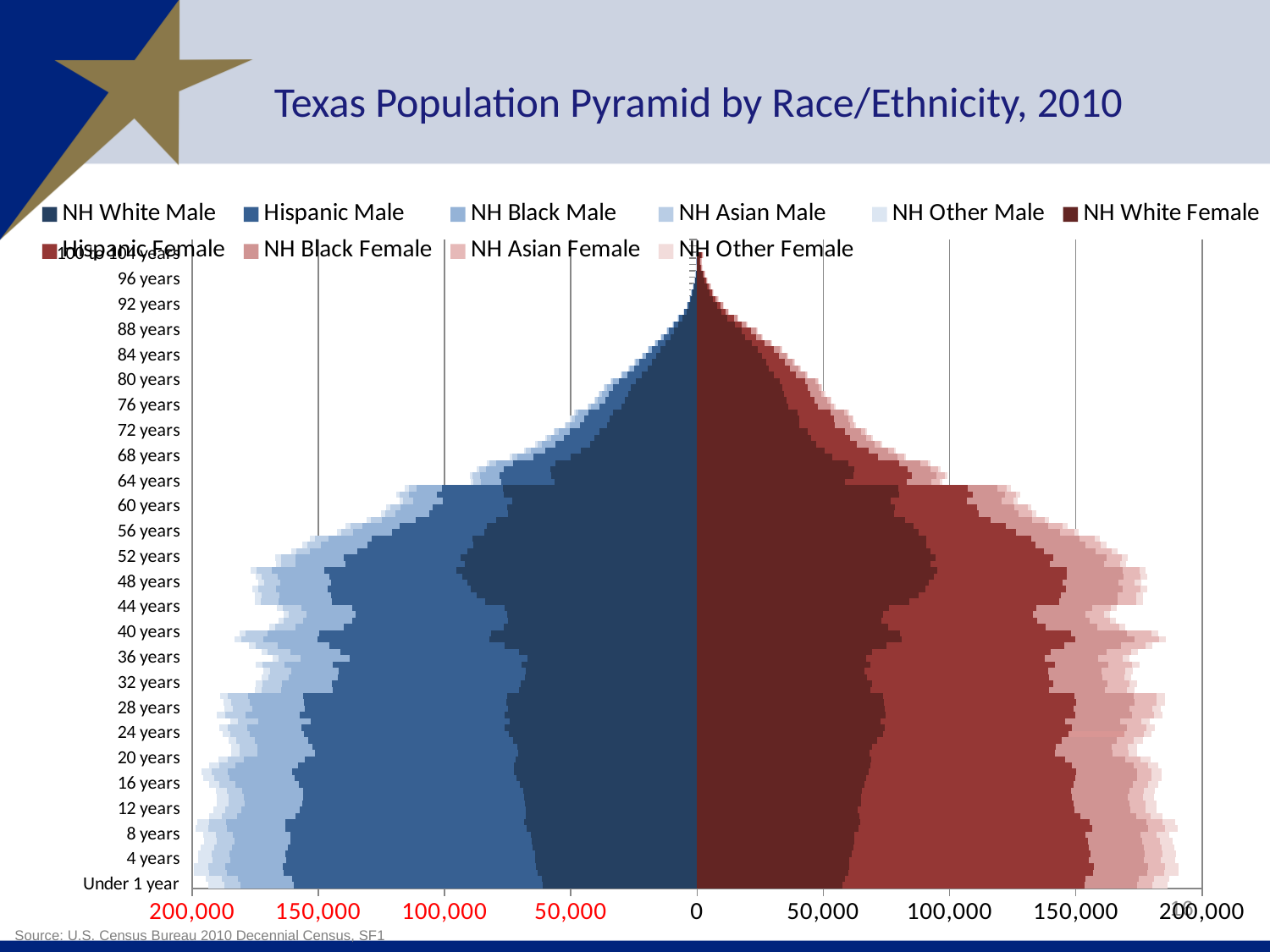
How many series does the legend list? 10 Is the total female population at 88 years greater or less than 50,000? less Is the total male population at 88 years greater or less than 50,000? less Is the total female population at 64 years greater or less than 150,000? less Which side of the pyramid shows the male series, left or right? Left What is the title of the chart? Texas Population Pyramid by Race/Ethnicity, 2010 What kind of chart is shown on the slide? Bar chart (population pyramid) Moving from the youngest ages at the bottom to the oldest ages at the top, do the bar lengths generally increase or decrease? Decrease